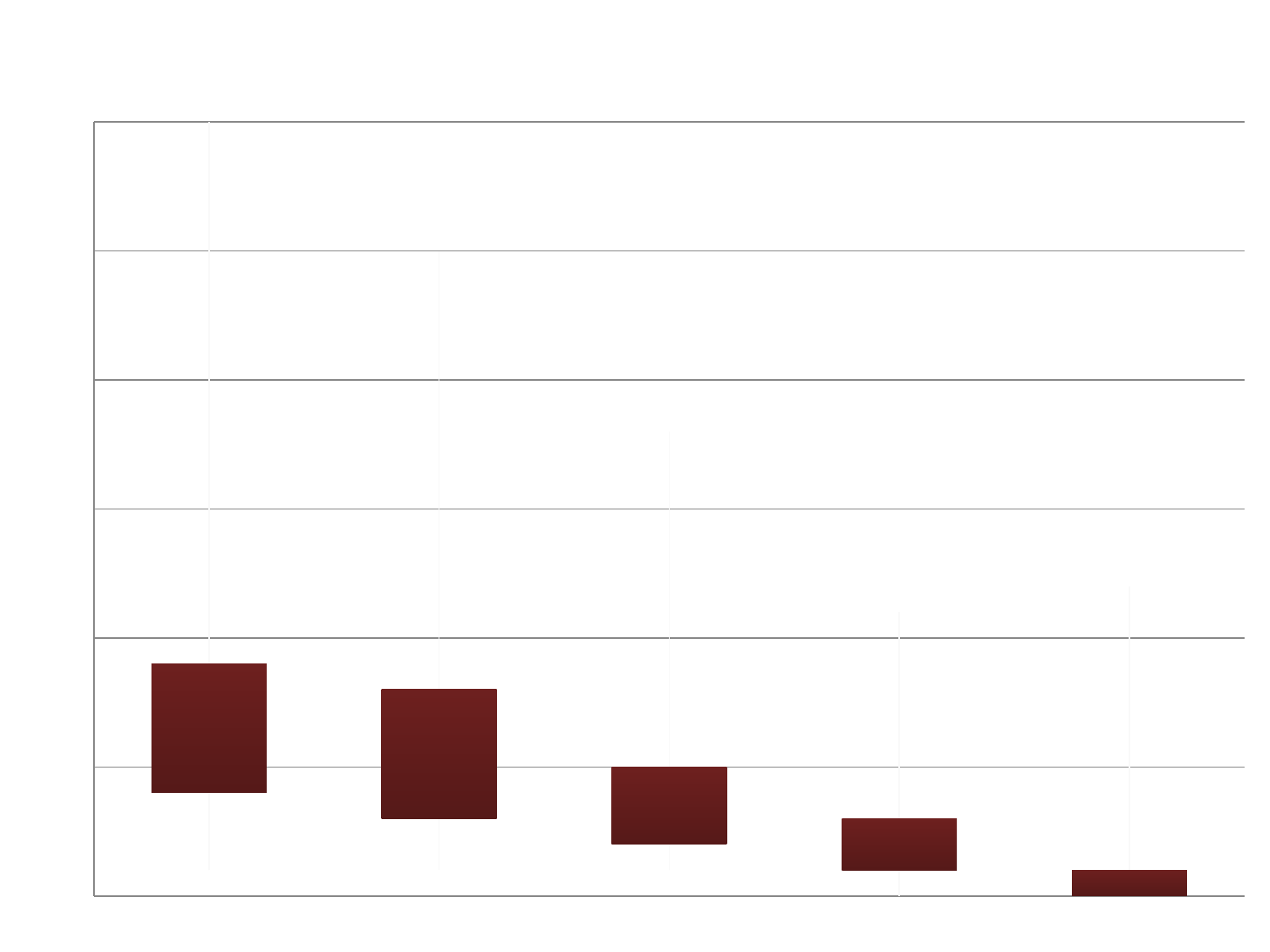
Does the chart display a legend? No How many bars are plotted on the chart? 5 What colour are the bars on the chart? dark red Do the bars rise or fall from left to right across the chart? fall Which bar on the chart is the shortest? the rightmost bar Is the leftmost bar taller or shorter than the rightmost bar? taller What kind of chart is shown on the slide? stock chart